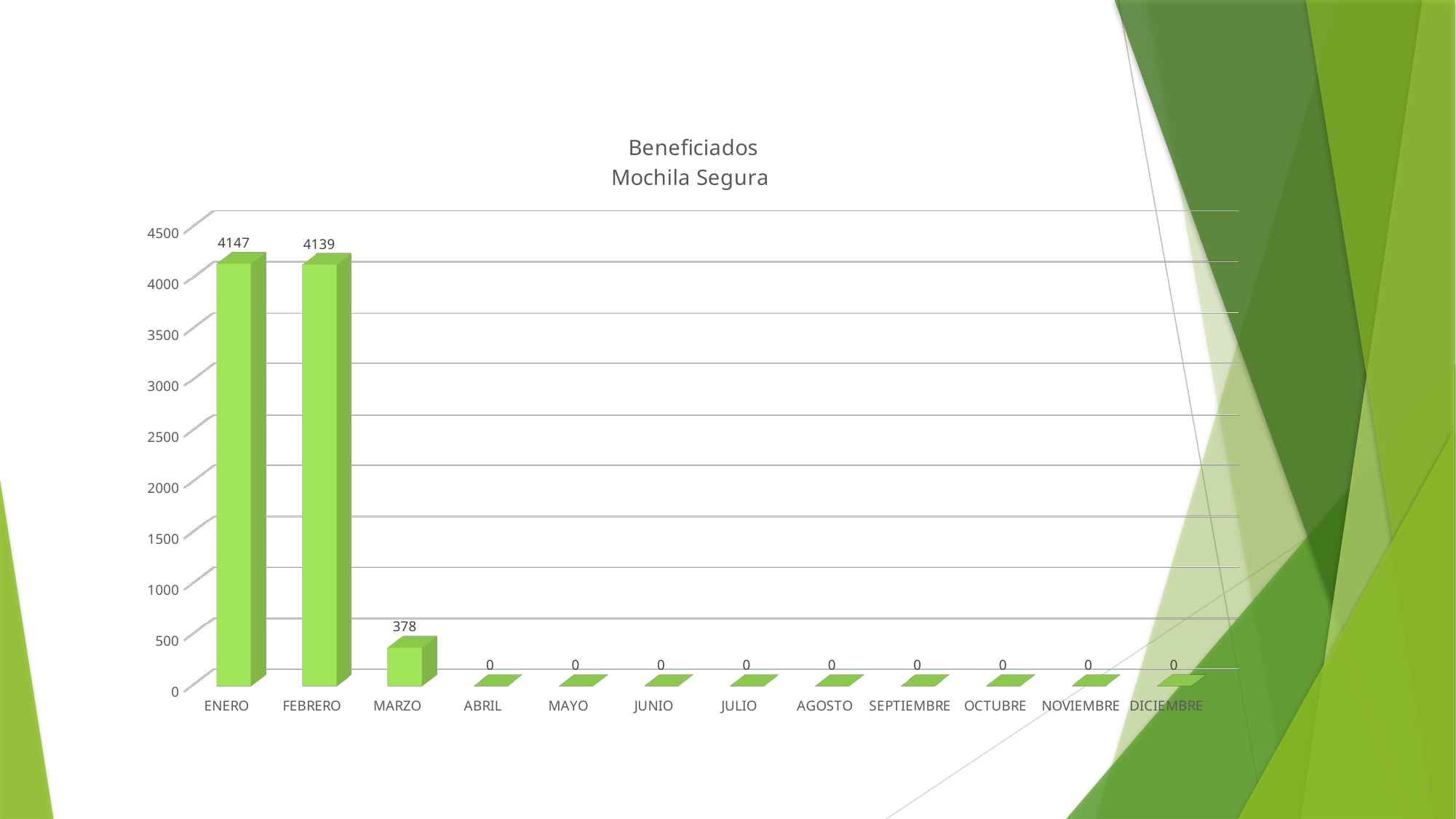
What kind of chart is shown? bar chart What is the difference between the values for ENERO and FEBRERO? 8 What is the title of the chart? Beneficiados Mochila Segura Is the value for MARZO greater or less than 500? less What is the value for MARZO? 378 What is the value for ENERO? 4147 Which is larger, the value for MARZO or the value for ABRIL? MARZO How many months are shown on the x axis? 12 What is the value for FEBRERO? 4139 What is the value for ABRIL? 0 Which month has the highest value? ENERO What is the difference between the values for FEBRERO and MARZO? 3761